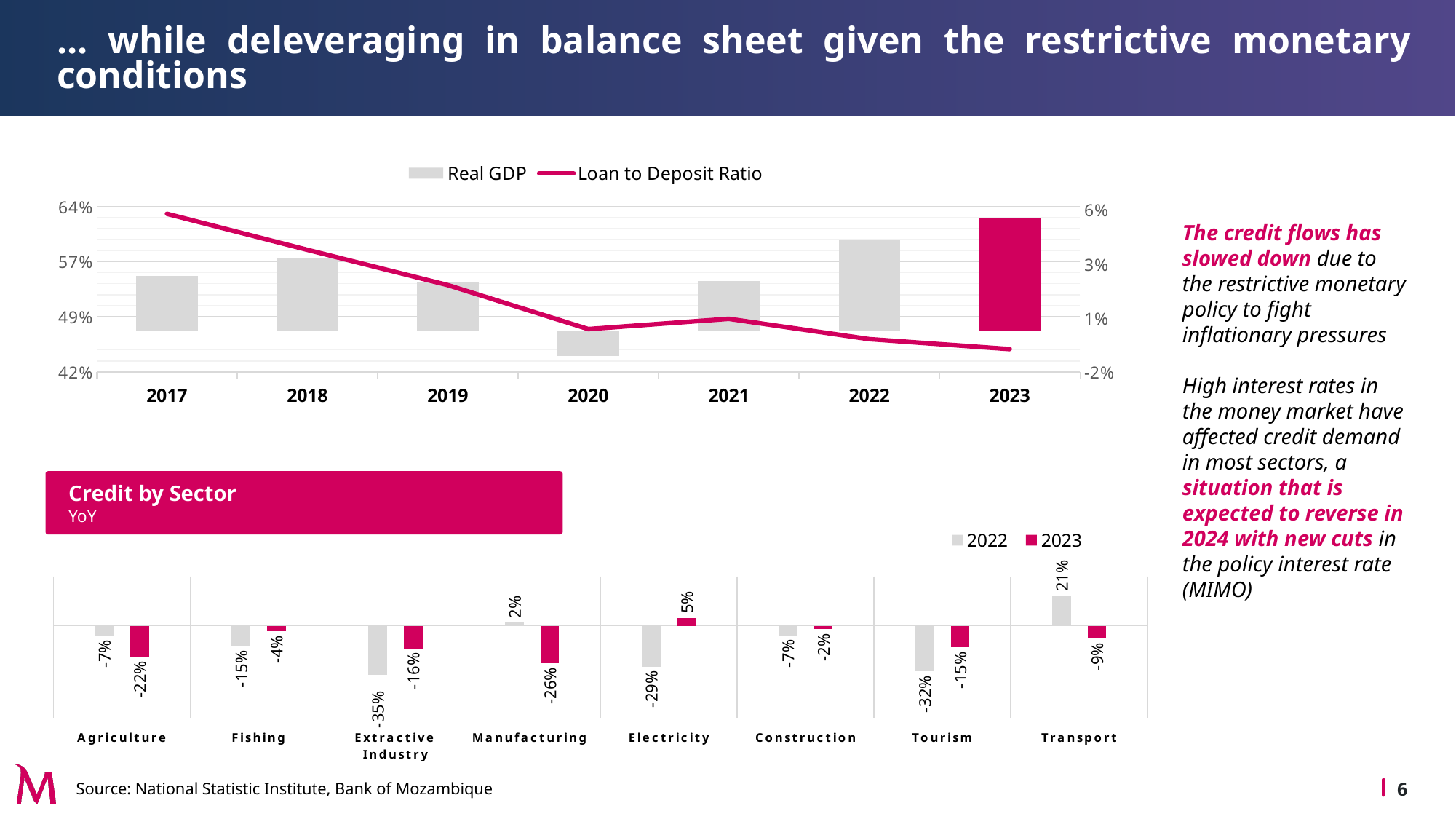
In the top chart, which year has the lowest Real GDP bar? 2020 In the top chart, is the Loan to Deposit Ratio for 2023 greater or less than 49%? less In the Credit by Sector chart, which is larger for Electricity: the 2022 value or the 2023 value? 2023 In the Credit by Sector chart, what is the 2023 value for Agriculture? -22% In the Credit by Sector chart, what is the difference between the 2022 and 2023 values for Manufacturing? 28 percentage points In the top chart, which year has the highest Real GDP bar? 2023 In the Credit by Sector chart, which sector has the lowest 2022 value? Extractive Industry In the Credit by Sector chart, what is the 2022 value for Transport? 21% How many sectors are shown in the Credit by Sector chart? 8 In the top chart, does the Loan to Deposit Ratio rise or fall from 2017 to 2023? fall In the top chart, is the Loan to Deposit Ratio for 2017 greater or less than 57%? greater In the top chart, how many series does the legend list? 2